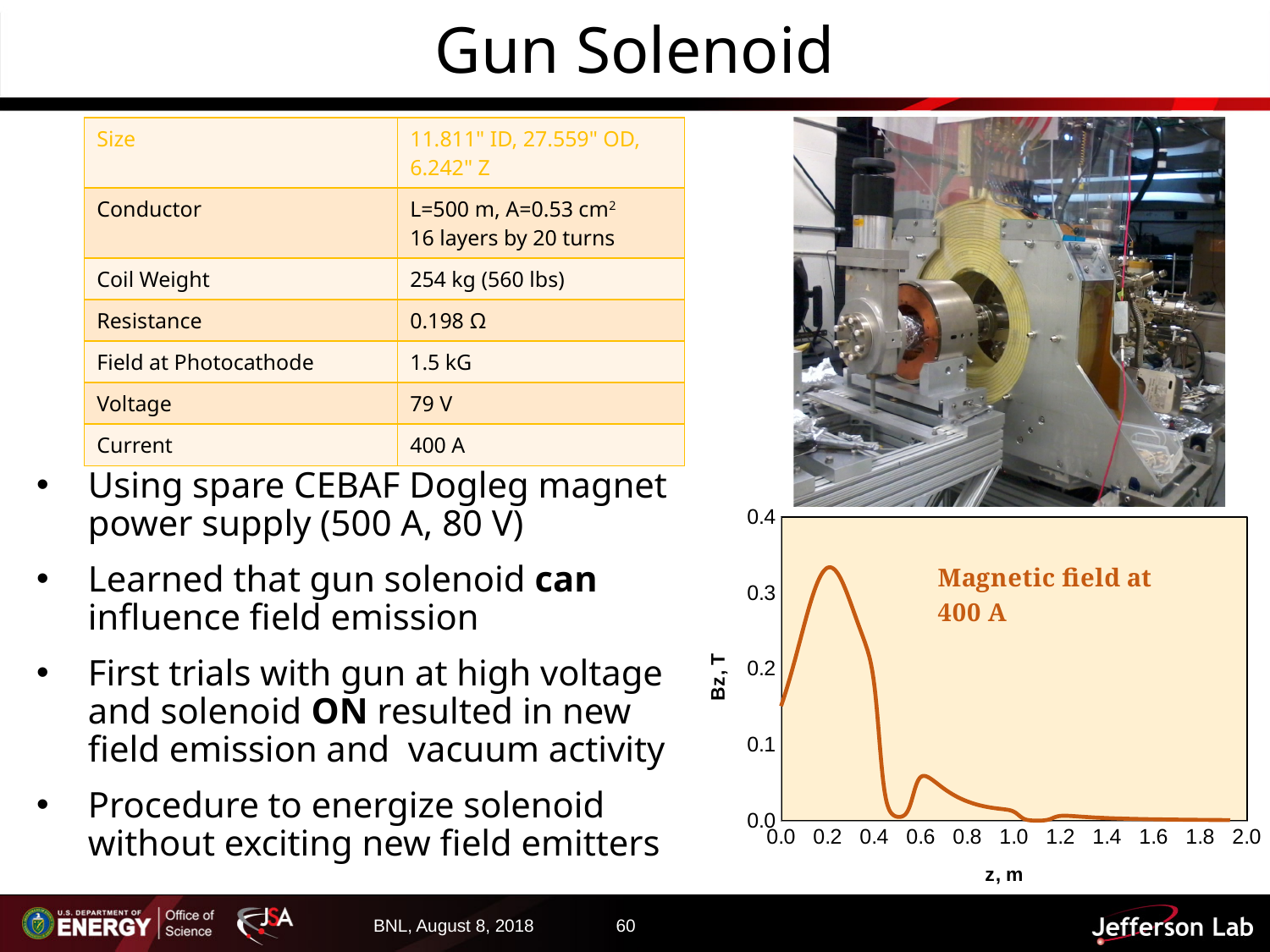
In the magnetic field chart, is the value of Bz at z = 0.0 m greater or less than 0.2? less In the magnetic field chart, is the value of Bz at z = 1.0 m greater or less than 0.1? less How many lines are plotted in the magnetic field chart? 1 In the magnetic field chart, is the value of Bz at z = 0.6 m greater or less than 0.1? less What is the label of the y axis of the magnetic field chart? Bz, T What is the label of the x axis of the magnetic field chart? z, m In the magnetic field chart, is Bz larger at z = 0.2 m or at z = 0.6 m? z = 0.2 m In the magnetic field chart, does Bz rise or fall as z increases from 0.0 m to 0.2 m? rise In the magnetic field chart, does Bz rise or fall as z increases from 0.2 m to 0.5 m? fall What kind of chart is shown at the bottom right of the slide? line chart